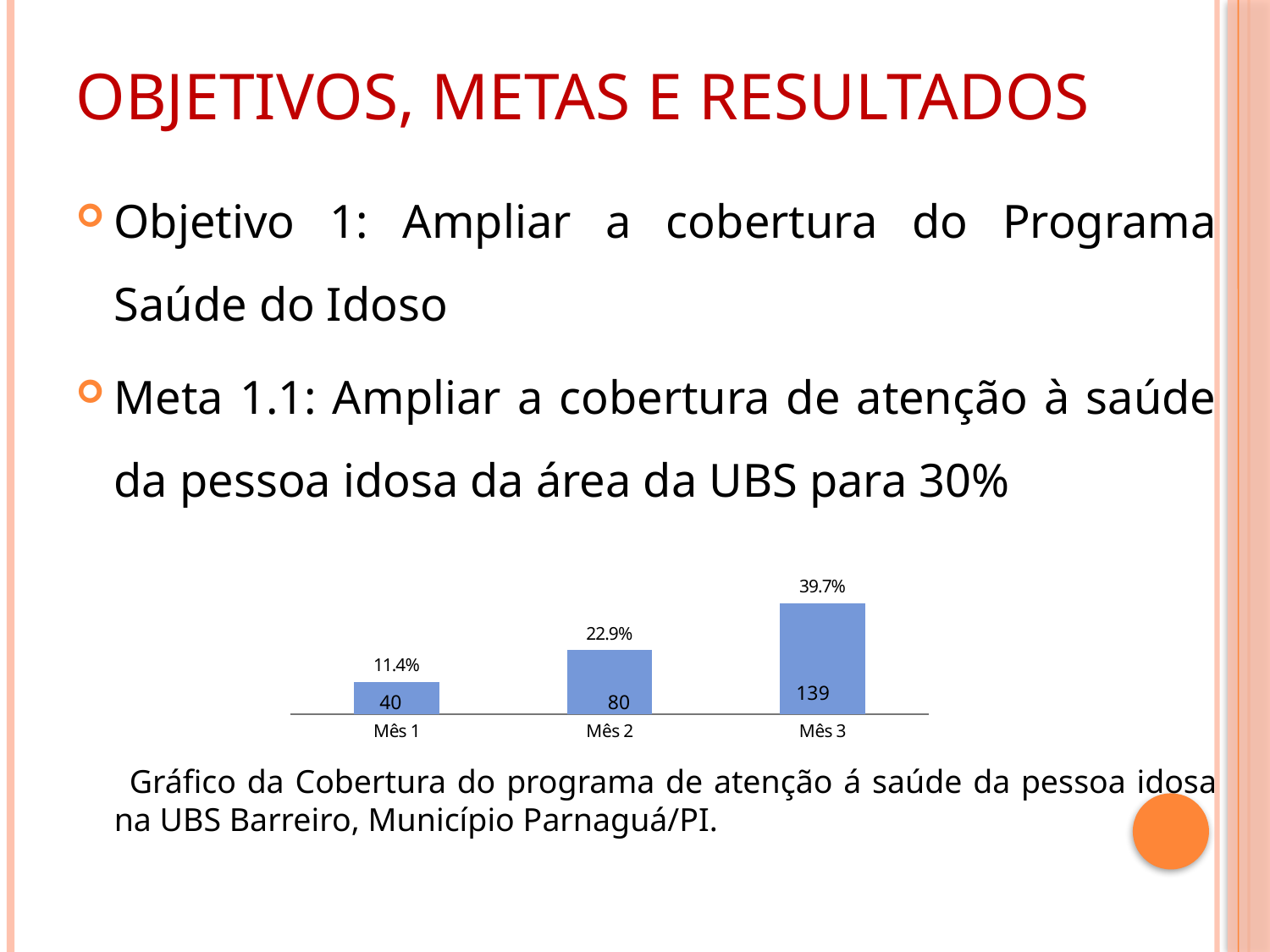
What number is printed inside the bar for Mês 3? 139 Which is larger, the value for Mês 2 or Mês 3? Mês 3 Which month has the lowest bar? Mês 1 What is the difference between the numbers inside the bars for Mês 2 and Mês 1? 40 How many months are shown on the x axis? 3 What kind of chart is shown on the slide? Bar chart What percentage is shown above the bar for Mês 2? 22.9% What percentage is shown above the bar for Mês 1? 11.4% Which month has the highest bar? Mês 3 What is the difference between the percentages for Mês 3 and Mês 2? 16.8% What percentage is shown above the bar for Mês 3? 39.7% What number is printed inside the bar for Mês 1? 40